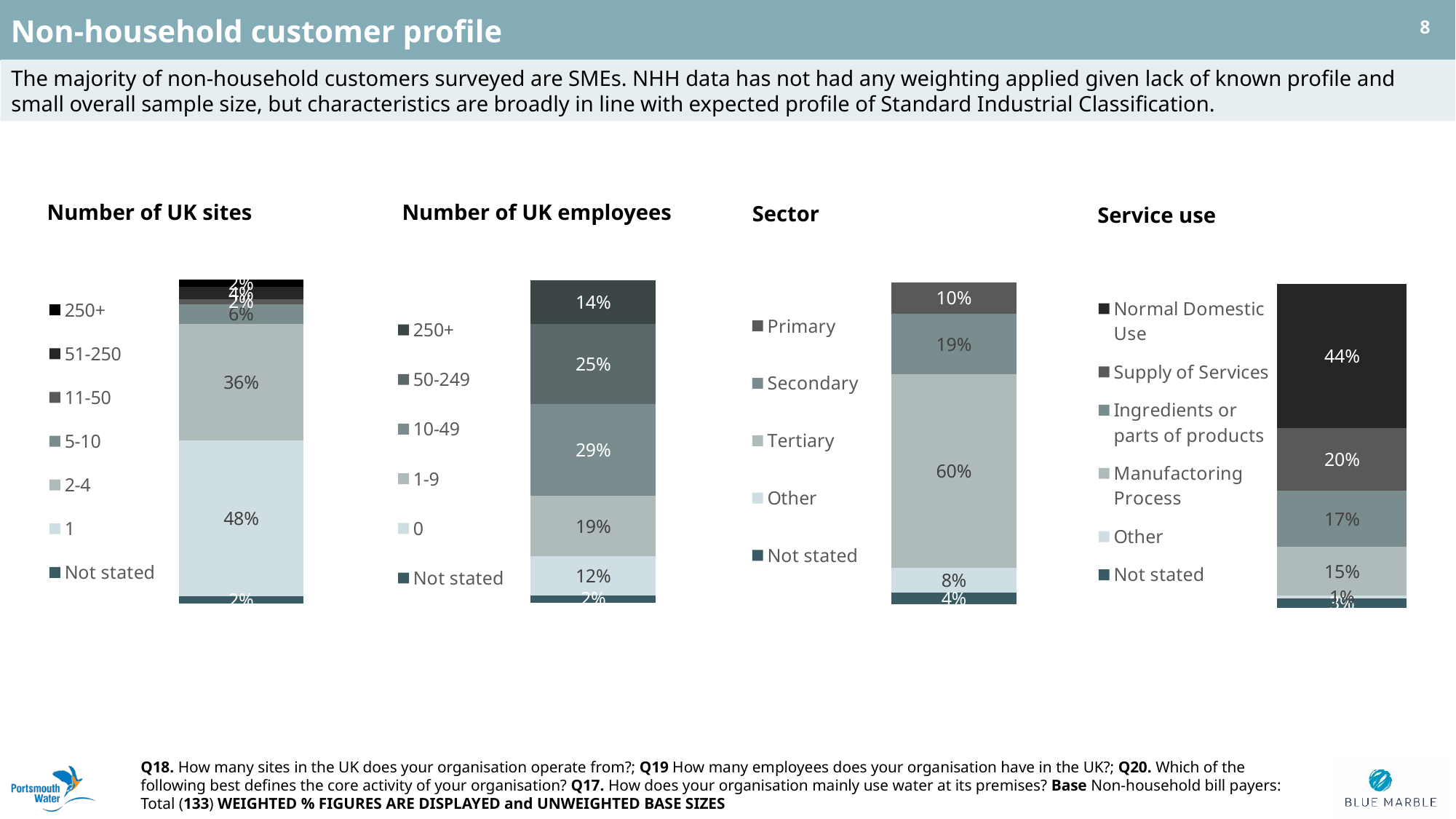
In the 'Service use' chart, what percentage of organisations use water for Normal Domestic Use? 44% In the 'Sector' chart, which sector has the smallest share among Primary, Secondary and Tertiary? Primary How many charts are shown on the slide? 4 What type of chart is used for 'Number of UK employees'? Stacked bar chart In the 'Sector' chart, what percentage of organisations are in the Tertiary sector? 60% In the 'Number of UK employees' chart, what is the difference between the 50-249 share and the 1-9 share? 6% In the 'Number of UK employees' chart, what percentage of organisations have 10-49 employees? 29% How many categories does the legend of the 'Sector' chart list? 5 In the 'Number of UK sites' chart, which category has the largest share? 1 In the 'Number of UK employees' chart, what percentage of organisations have 250+ employees? 14% In the 'Number of UK sites' chart, what percentage of organisations operate from 2-4 sites? 36% In the 'Service use' chart, which is larger: Supply of Services or Manufactoring Process? Supply of Services